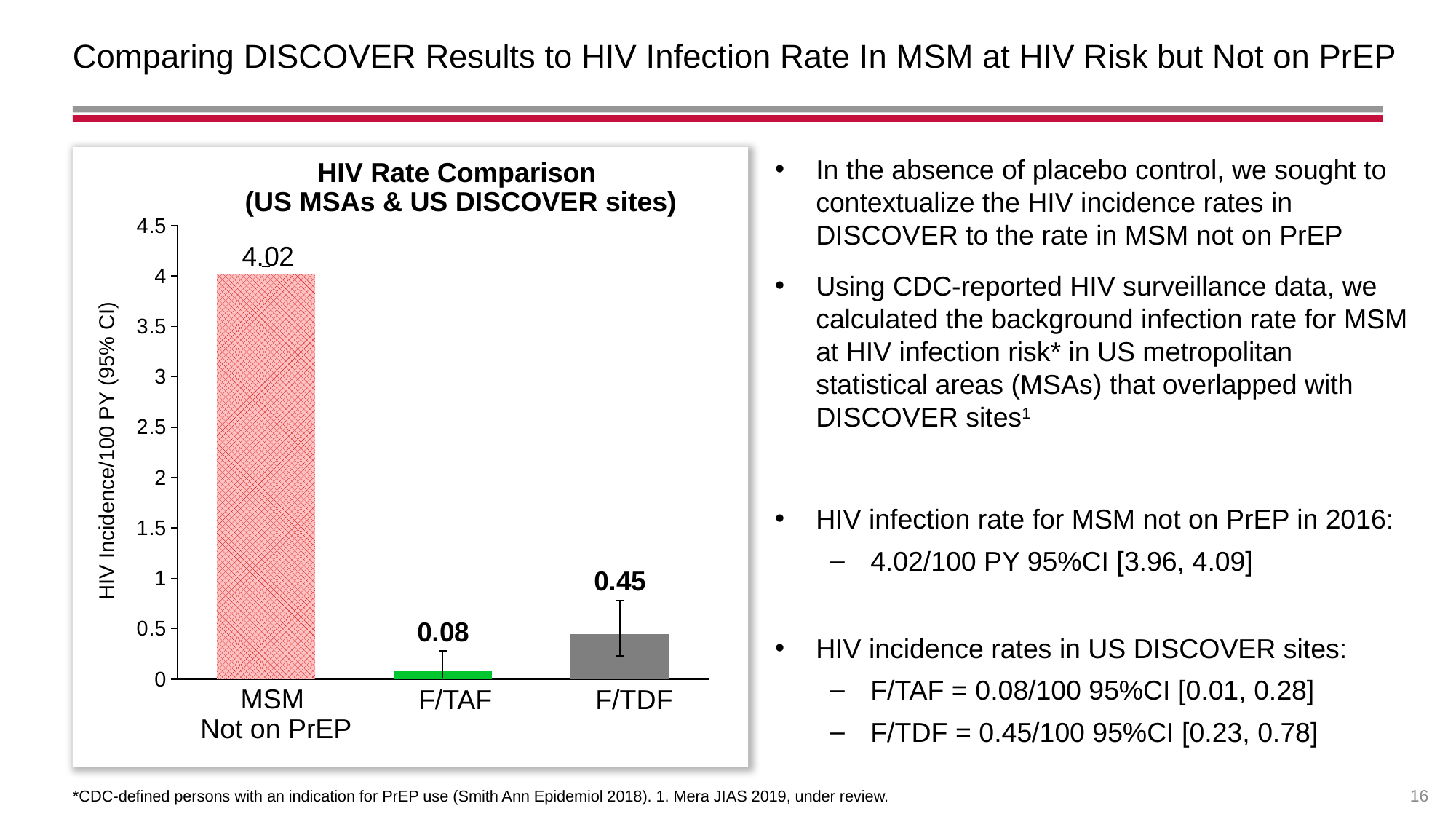
What is the title of the chart? HIV Rate Comparison (US MSAs & US DISCOVER sites) Which has a higher HIV incidence, F/TAF or F/TDF? F/TDF What is the HIV incidence per 100 PY for F/TAF in the chart? 0.08 What is the difference in HIV incidence between MSM Not on PrEP and F/TDF? 3.57 Is the value for MSM Not on PrEP greater or less than 4? greater Which category has the lowest HIV incidence in the chart? F/TAF What type of chart is shown on the slide? bar chart What is the HIV incidence per 100 PY for MSM Not on PrEP in the chart? 4.02 How many categories are shown on the x axis of the chart? 3 Which category has the highest HIV incidence in the chart? MSM Not on PrEP What is the HIV incidence per 100 PY for F/TDF in the chart? 0.45 What is the difference in HIV incidence between F/TDF and F/TAF? 0.37